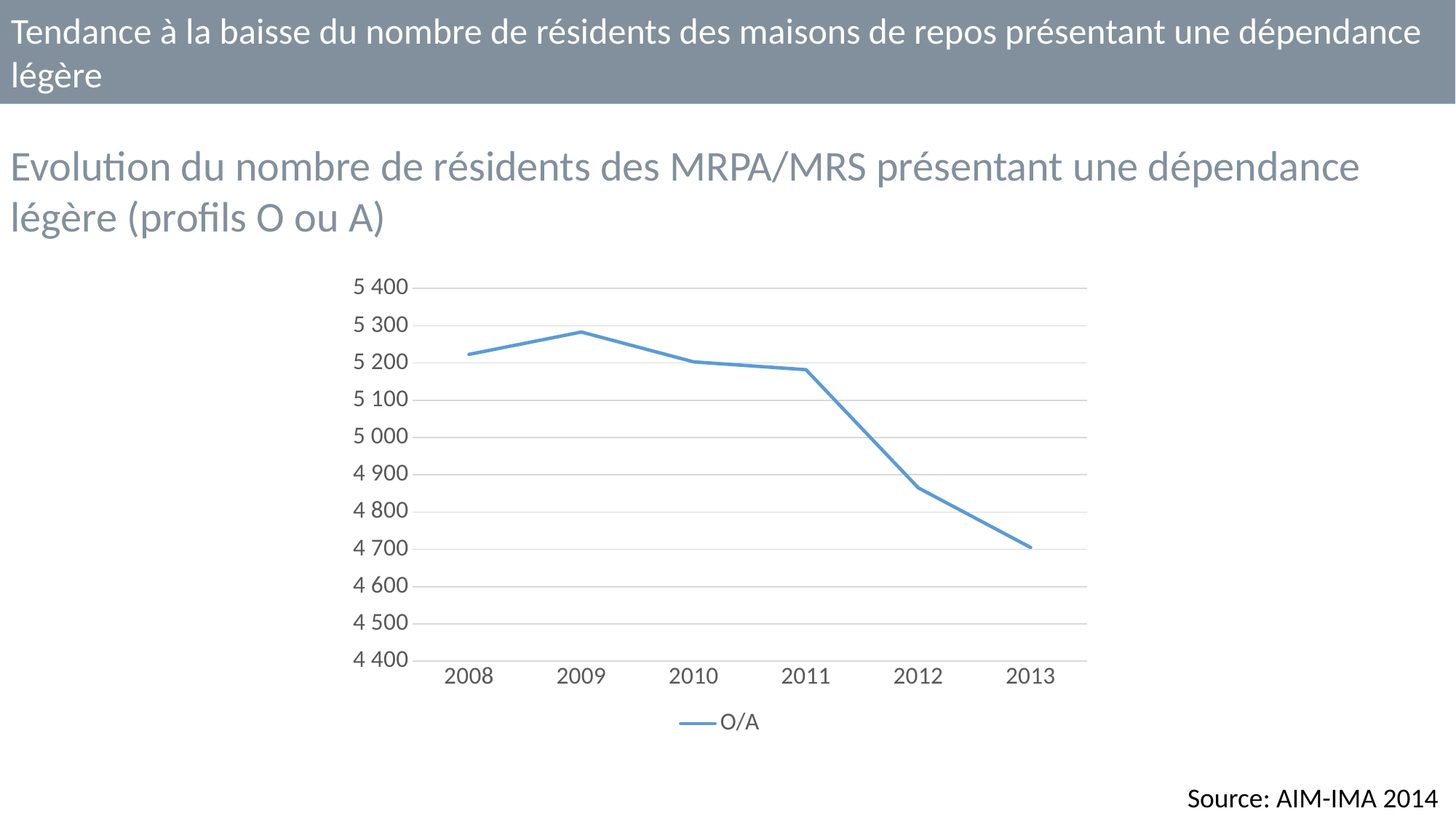
Is the value for 2012 greater or less than 4 900? less In which year is the number of O/A residents lowest? 2013 What is the name of the series shown in the legend? O/A How many series does the legend list? 1 Which year has the larger value, 2008 or 2012? 2008 Is the value for 2010 greater or less than 5 100? greater Is the value for 2013 greater or less than 4 800? less Overall, do the values rise or fall from 2009 to 2013? fall What kind of chart is shown on the slide? line chart In which year is the number of O/A residents highest? 2009 How many years are plotted on the x axis? 6